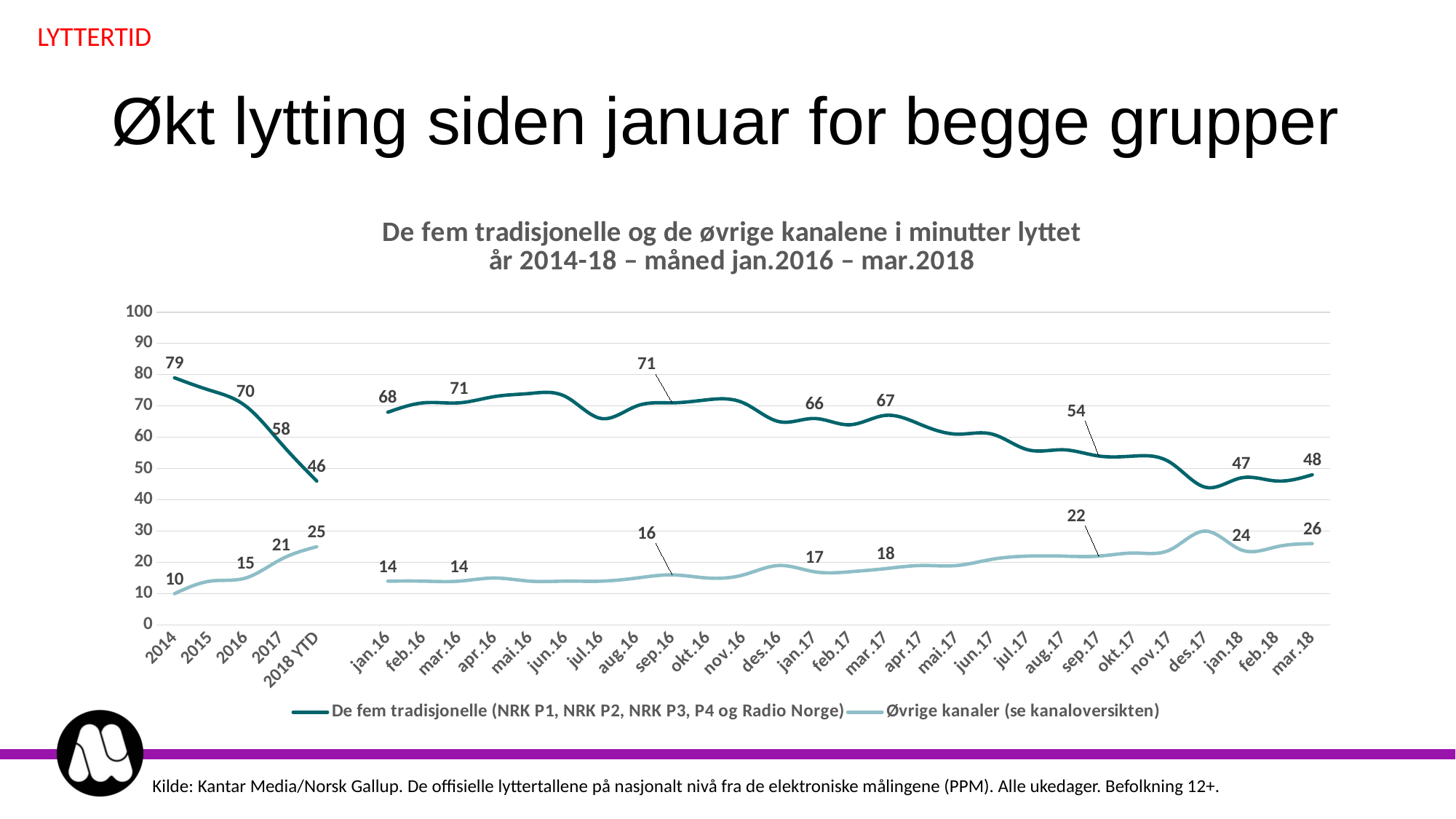
What is the value for De fem tradisjonelle in 2014? 79 By how much did De fem tradisjonelle fall from jan.16 (68) to mar.18 (48)? 20 What is the value for De fem tradisjonelle in mar.18? 48 What is the value for Øvrige kanaler in jan.16? 14 What is the difference between De fem tradisjonelle and Øvrige kanaler in mar.18? 22 In jan.17, which series has the higher value, De fem tradisjonelle or Øvrige kanaler? De fem tradisjonelle What kind of chart is shown on the slide? line chart What is the value for Øvrige kanaler in mar.18? 26 Does the De fem tradisjonelle line rise or fall overall from jan.16 to mar.18? fall Is the value for De fem tradisjonelle in des.17 greater or less than 50? less What is the first line of the chart title? De fem tradisjonelle og de øvrige kanalene i minutter lyttet How many series does the legend list? 2